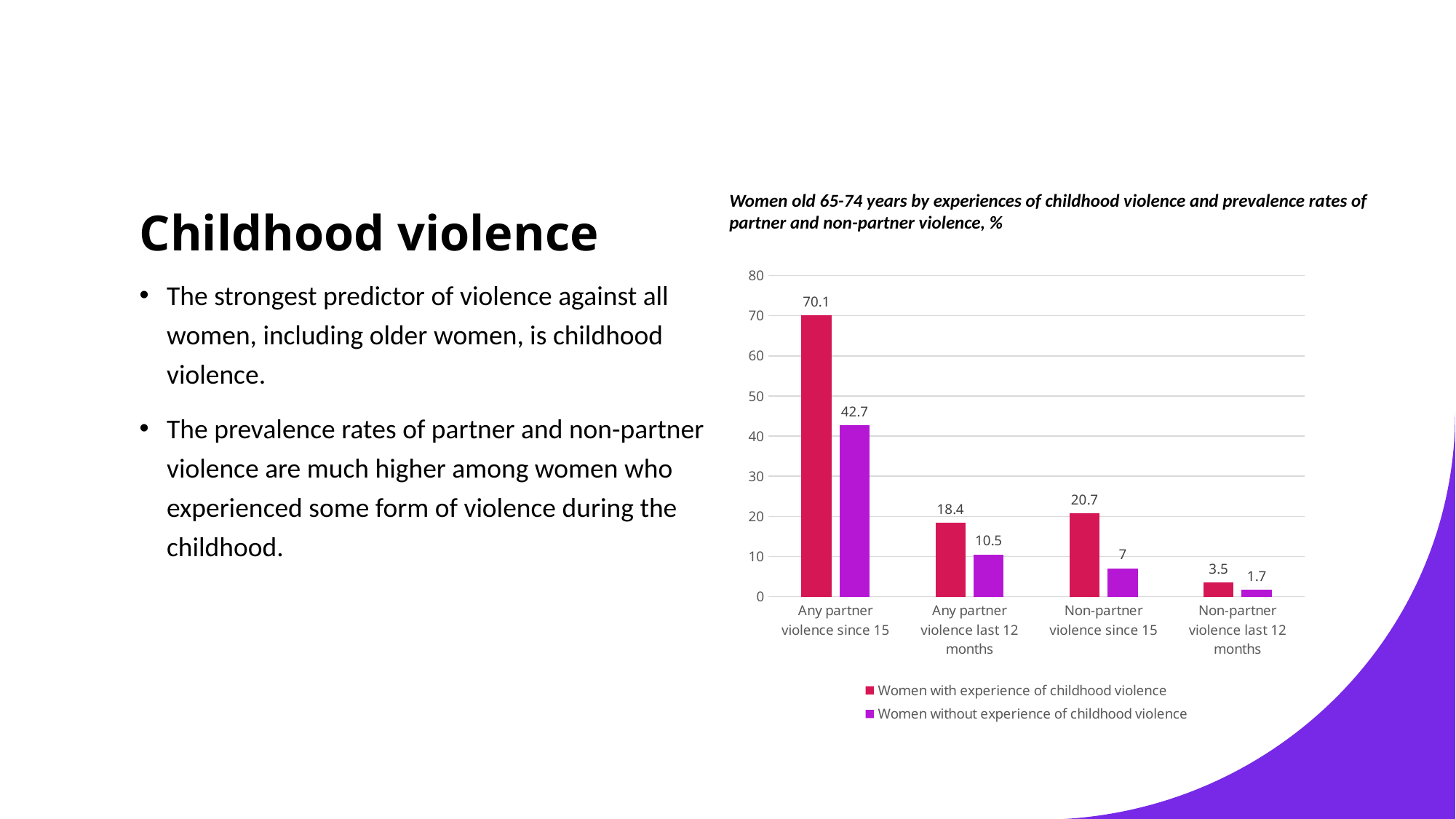
Which category has the lowest value for women without experience of childhood violence? Non-partner violence last 12 months What is the value for 'Non-partner violence last 12 months' among women without experience of childhood violence? 1.7 What is the title of the chart? Women old 65-74 years by experiences of childhood violence and prevalence rates of partner and non-partner violence, % What kind of chart is shown on the slide? Bar chart For 'Non-partner violence since 15', which series has the larger value? Women with experience of childhood violence How many series does the legend list? 2 What is the value for 'Any partner violence since 15' among women with experience of childhood violence? 70.1 How many categories are shown on the x axis? 4 Is the value for 'Non-partner violence since 15' among women with experience of childhood violence greater or less than 20? greater Which category has the highest value for women with experience of childhood violence? Any partner violence since 15 What is the difference between the two series for 'Any partner violence since 15'? 27.4 What is the value for 'Any partner violence last 12 months' among women without experience of childhood violence? 10.5